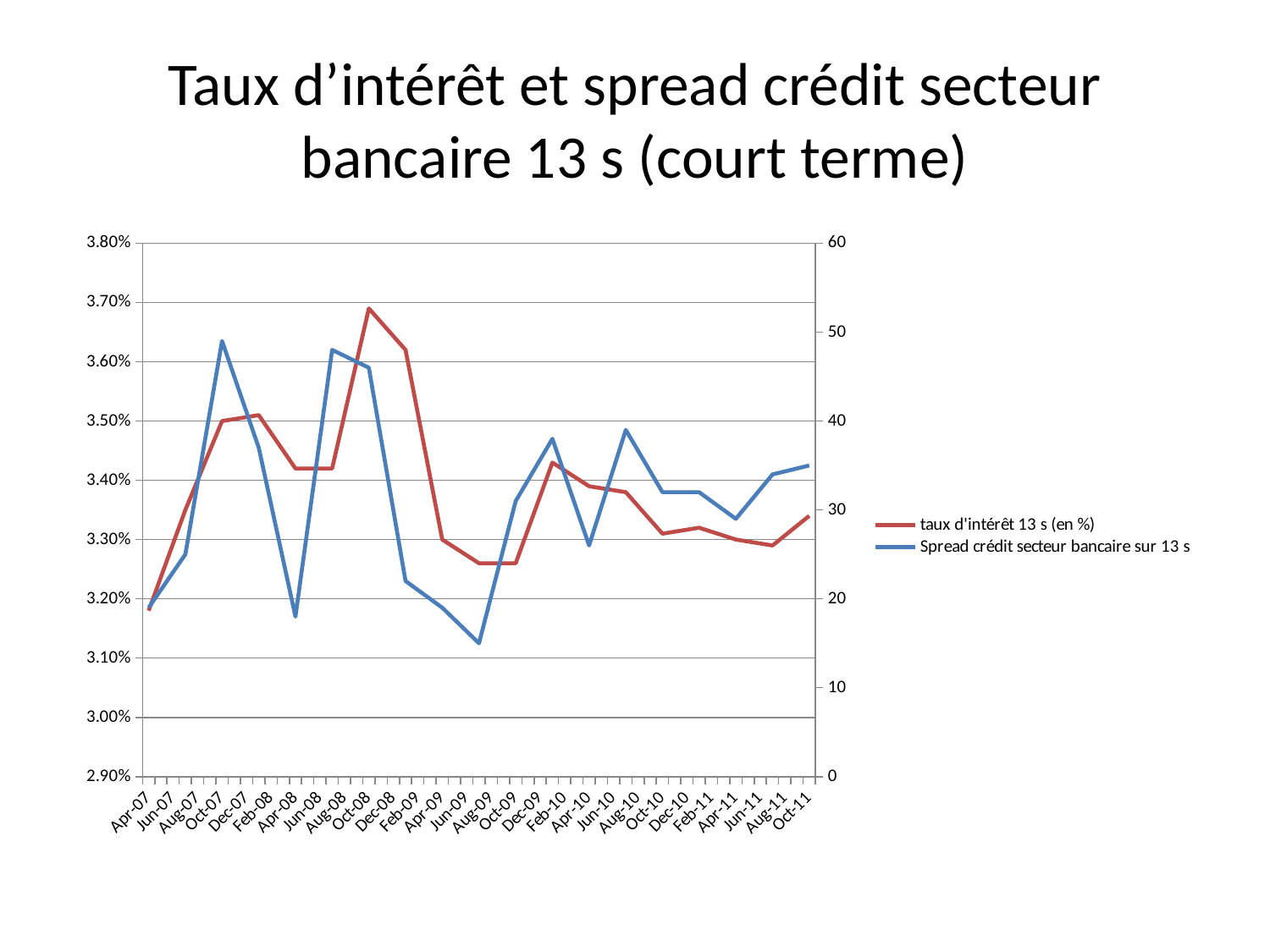
At which date does the 'taux d'intérêt 13 s (en %)' series reach its highest value? Oct-08 Is the value of 'taux d'intérêt 13 s (en %)' at Oct-08 greater or less than 3.60%? greater How many series does the legend list? 2 What colour is the line for 'Spread crédit secteur bancaire sur 13 s'? blue Which is larger for 'taux d'intérêt 13 s (en %)': the value at Feb-10 or the value at Oct-10? Feb-10 Is the value of 'Spread crédit secteur bancaire sur 13 s' at Jun-09 greater or less than 20? less At which date does the 'taux d'intérêt 13 s (en %)' series reach its lowest value? Apr-07 Is the value of 'Spread crédit secteur bancaire sur 13 s' at Oct-07 greater or less than 40? greater How many date labels appear along the x axis? 28 What kind of chart is shown on the slide? line chart Does the 'taux d'intérêt 13 s (en %)' series rise or fall between Oct-08 and Jun-09? fall